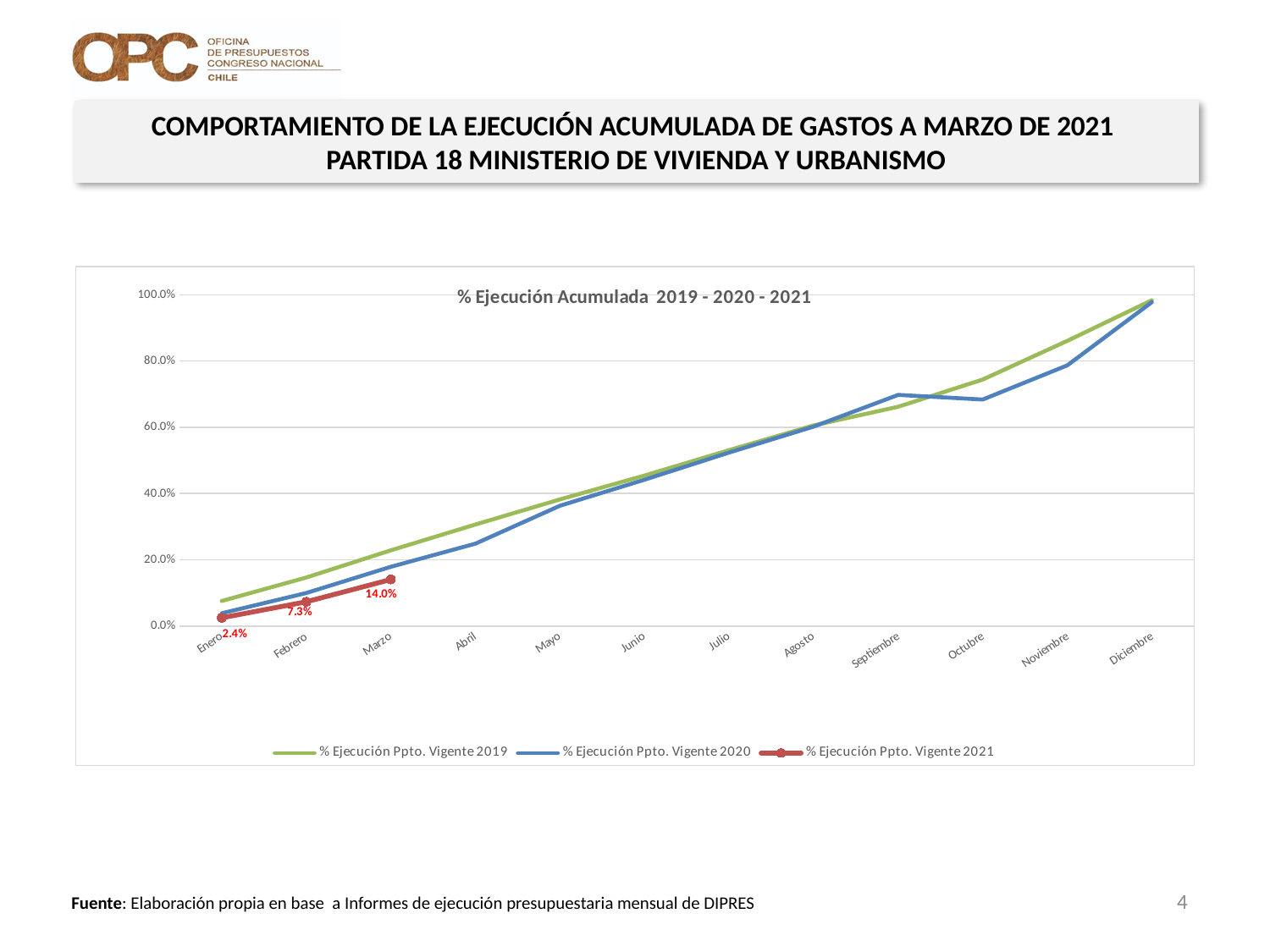
Does the % Ejecución Ppto. Vigente 2021 series rise or fall from Enero to Marzo? Rises In Octubre, which series has the higher value: % Ejecución Ppto. Vigente 2019 or % Ejecución Ppto. Vigente 2020? % Ejecución Ppto. Vigente 2019 What kind of chart is shown on the slide? Line chart What is the difference between the Marzo and Enero values of % Ejecución Ppto. Vigente 2021? 11.6% What is the difference between the Marzo and Febrero values of % Ejecución Ppto. Vigente 2021? 6.7% How many months are shown on the x axis of the chart? 12 What is the value of % Ejecución Ppto. Vigente 2021 for Marzo? 14.0% How many series does the chart legend list? 3 Is the value of % Ejecución Ppto. Vigente 2019 for Diciembre greater or less than 80%? greater What is the value of % Ejecución Ppto. Vigente 2021 for Febrero? 7.3% What is the title of the chart? % Ejecución Acumulada 2019 - 2020 - 2021 What is the value of % Ejecución Ppto. Vigente 2021 for Enero? 2.4%